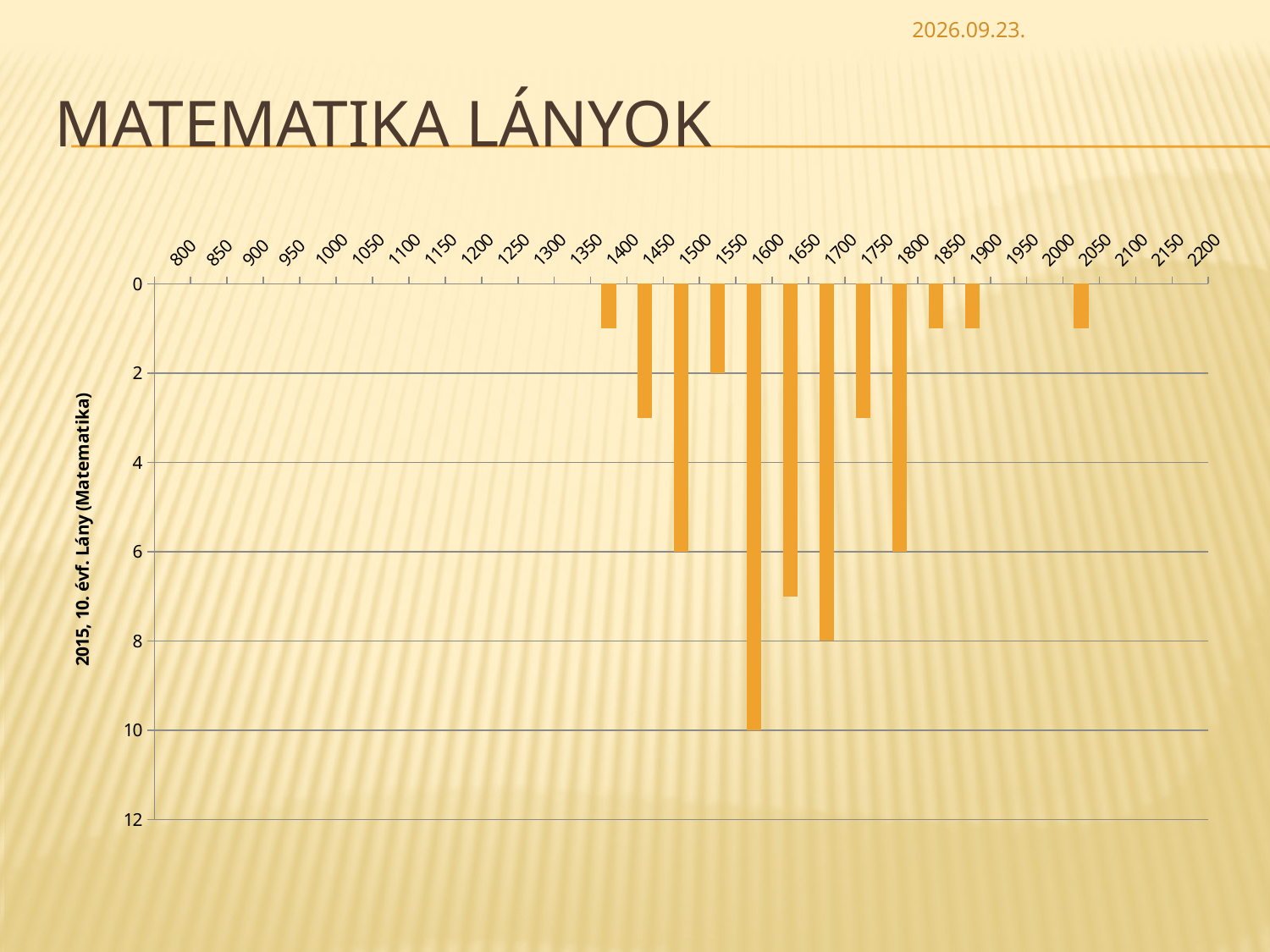
What is the label on the vertical axis of the chart? 2015, 10. évf. Lány (Matematika) Which category has the highest value in the chart? 1600 What is the value for the 1550 category? 2 What is the value for the 1700 category? 8 What is the title of the chart on the slide? MATEMATIKA LÁNYOK Which is larger, the value for 1650 or the value for 1750? 1650 What is the difference between the values for 1600 and 1700? 2 What is the value for the 1500 category? 6 What is the value for the 1600 category? 10 How many bars are plotted in the chart? 12 What kind of chart is shown on the slide? bar chart Is the value for 1650 greater or less than 6? greater